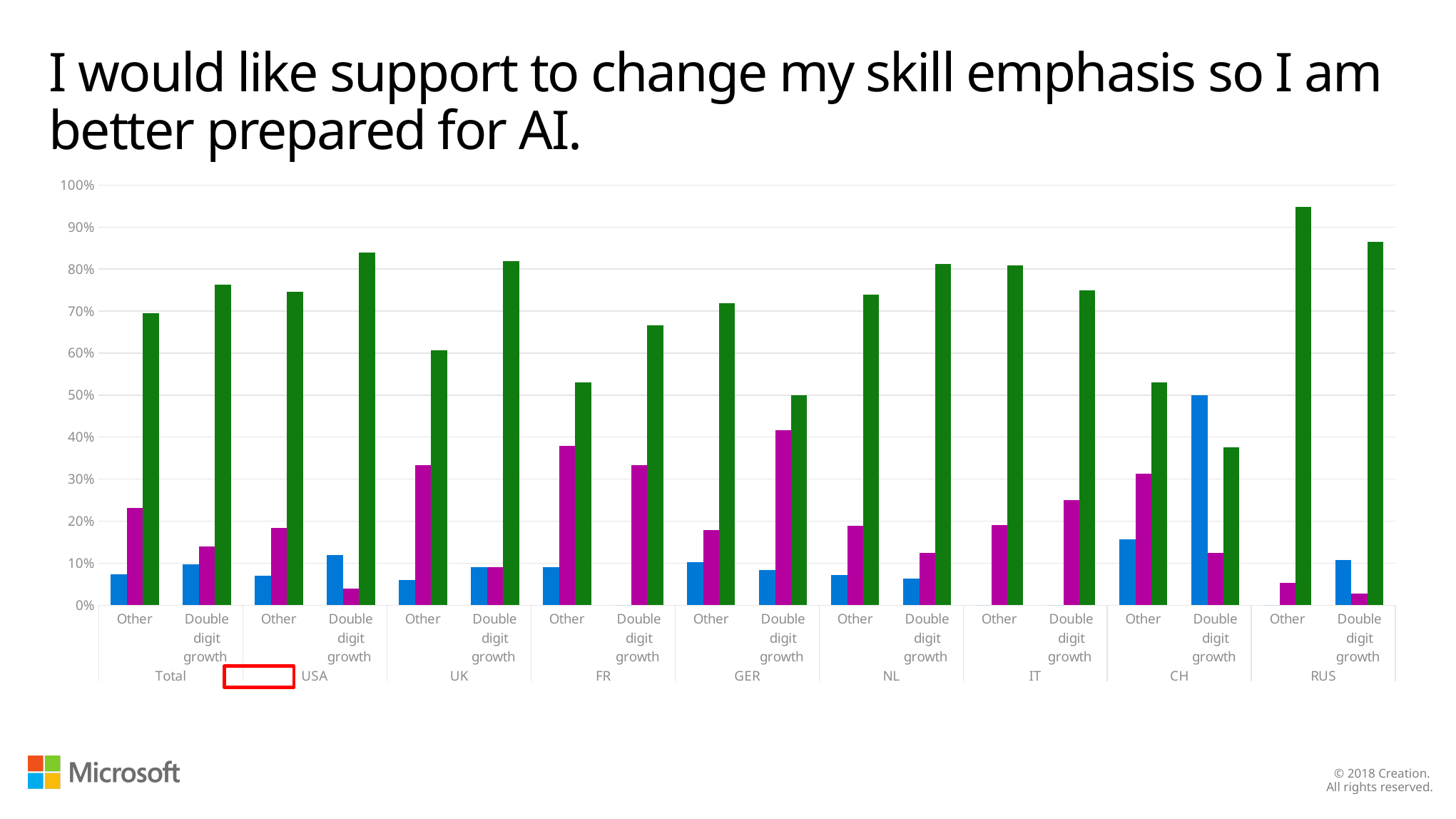
Is the green bar for CH Double digit growth greater or less than 40%? less Which category has the tallest blue bar? CH Double digit growth Is the green bar for RUS Other greater or less than 90%? greater How many country/region groups (including Total) are shown along the x axis? 9 Which category has the tallest green bar? RUS Other Is the green bar for USA Double digit growth greater or less than 80%? greater What kind of chart is shown on the slide? bar chart Which category has the shortest green bar? CH Double digit growth How many differently coloured bar series are plotted for each category? 3 Within the Total group, which green bar is taller: Other or Double digit growth? Double digit growth What is the title of the slide? I would like support to change my skill emphasis so I am better prepared for AI. Which category has the tallest magenta bar? GER Double digit growth